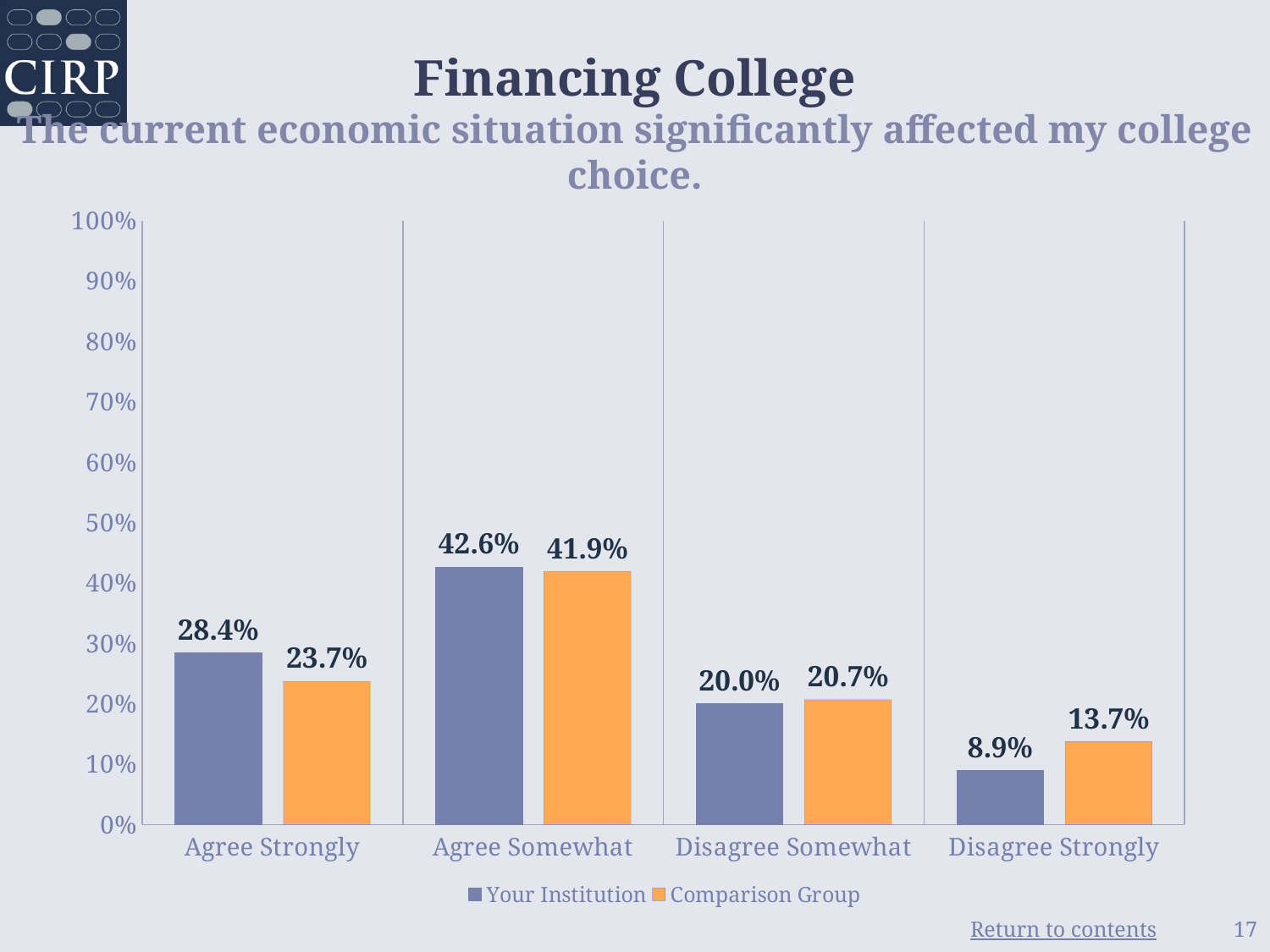
What is the difference between Your Institution and Comparison Group in the Agree Strongly category? 4.7% Which category has the highest value for Your Institution? Agree Somewhat How many series does the legend list? 2 What kind of chart is shown on the slide? bar chart Is the value for Your Institution in the Agree Somewhat category greater or less than 40%? greater Which category has the lowest value for Comparison Group? Disagree Strongly What is the value for Your Institution in the Agree Strongly category? 28.4% In the Disagree Strongly category, which is larger: Your Institution or Comparison Group? Comparison Group How many categories are shown on the x axis? 4 What is the value for Comparison Group in the Agree Somewhat category? 41.9% What is the value for Comparison Group in the Disagree Strongly category? 13.7% What colour are the bars for Comparison Group? orange